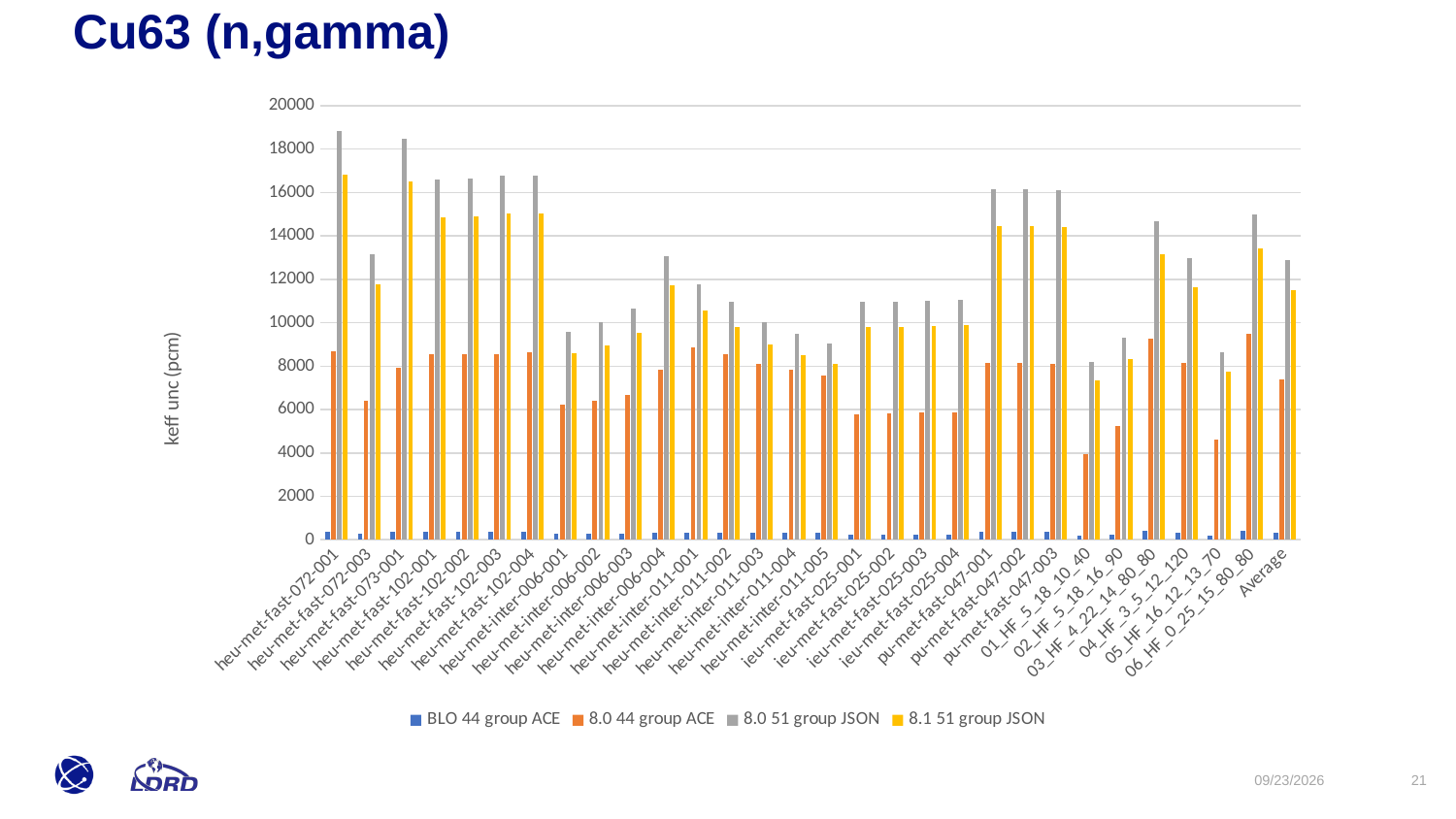
Is the 8.0 51 group JSON value for Average greater or less than 12000? greater For heu-met-fast-072-001, which is larger: the 8.0 51 group JSON value or the 8.1 51 group JSON value? 8.0 51 group JSON What is the label on the y axis? keff unc (pcm) Is the 8.0 51 group JSON value for heu-met-fast-072-001 greater or less than 18000? greater How many series does the legend list? 4 What is the title of the chart? Cu63 (n,gamma) Is the BLO 44 group ACE value for Average greater or less than 2000? less Which has the larger 8.0 44 group ACE value: heu-met-fast-072-001 or heu-met-fast-072-003? heu-met-fast-072-001 Which category has the lowest 8.0 44 group ACE value? 01_HF_5_18_10_40 What kind of chart is shown on the slide? bar chart How many categories are shown along the x axis? 30